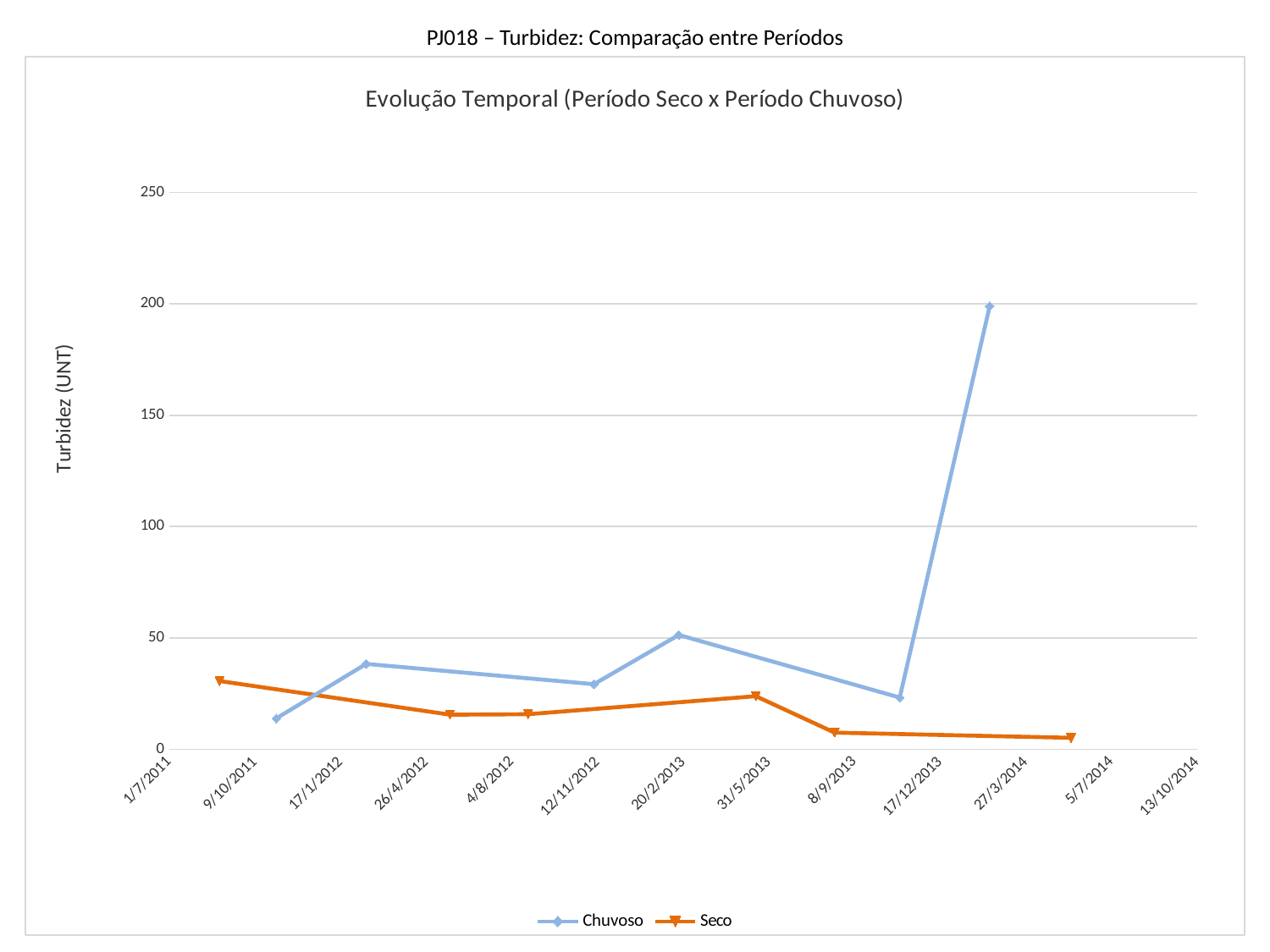
What kind of chart is shown on the slide? line chart What are the two series named in the legend? Chuvoso and Seco How many series does the legend list? 2 Which series reaches the highest value on the chart? Chuvoso What is the label of the vertical axis? Turbidez (UNT) Which series has the higher first plotted value, Chuvoso or Seco? Seco How many data points are plotted for the Seco series? 6 Is the last plotted value of the Seco series greater or less than 50? less Does the Chuvoso series rise or fall between its last two points? rise Is the highest value of the Chuvoso series greater or less than 150? greater Is the highest value of the Seco series greater or less than 50? less How many data points are plotted for the Chuvoso series? 6